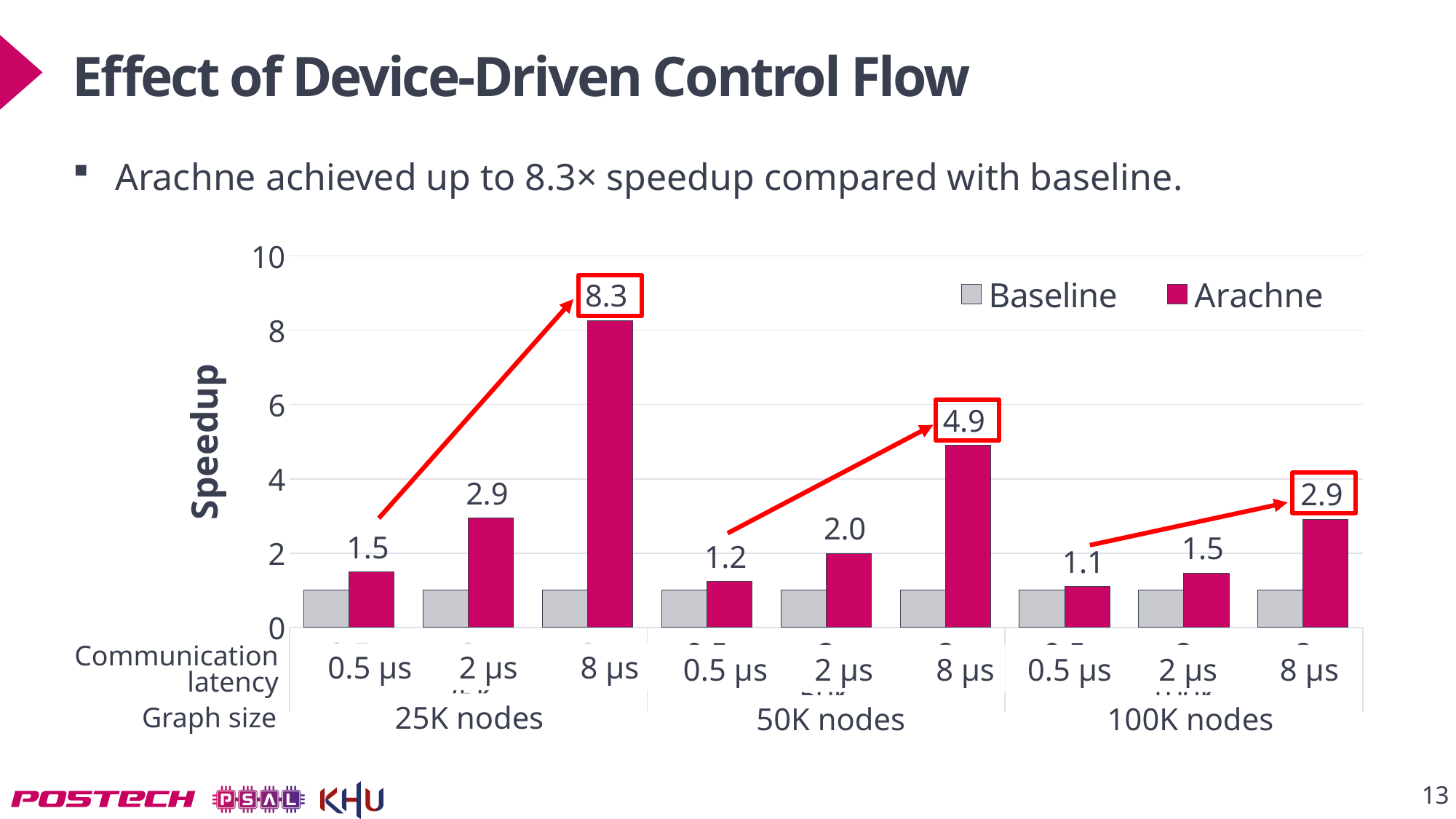
How many series does the legend list? 2 Within each graph size, does the Arachne speedup rise or fall as communication latency increases from 0.5 µs to 8 µs? Rises What is the Arachne speedup at 0.5 µs communication latency for 100K nodes? 1.1 What is the difference between the Arachne speedup at 8 µs for 25K nodes and at 8 µs for 50K nodes? 3.4 Which graph size and communication latency gives the lowest Arachne speedup? 100K nodes, 0.5 µs What is the Arachne speedup at 2 µs communication latency for 50K nodes? 2.0 Is the Arachne speedup at 8 µs for 50K nodes greater or less than 4? greater Which is larger: the Arachne speedup at 2 µs for 25K nodes or at 8 µs for 100K nodes? They are equal (2.9) Which graph size and communication latency gives the highest Arachne speedup? 25K nodes, 8 µs What is the Arachne speedup at 8 µs communication latency for 25K nodes? 8.3 What kind of chart is shown on the slide? Bar chart Is the Baseline value at 0.5 µs for 25K nodes greater or less than 2? less